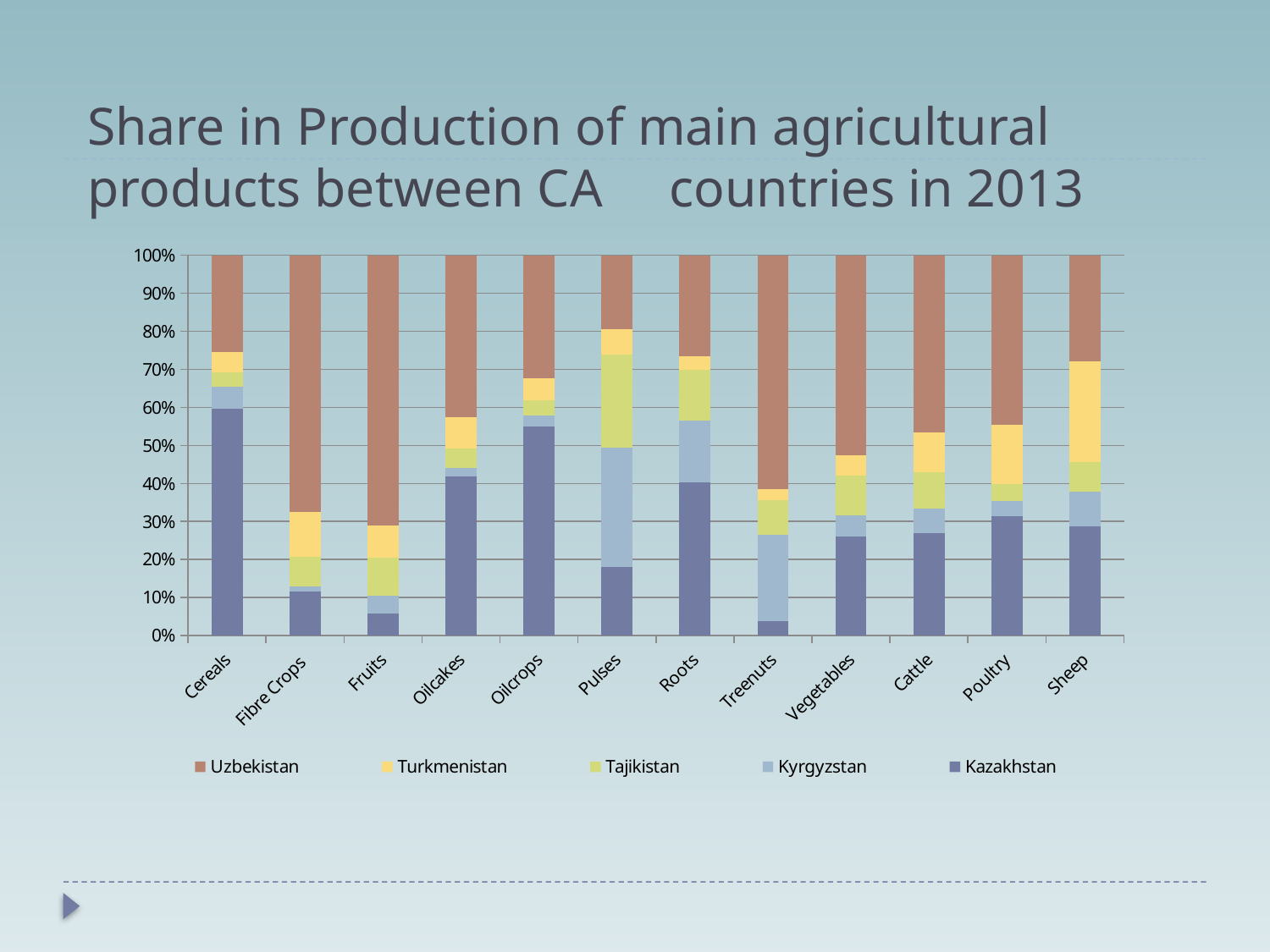
Is Kazakhstan's share of Fruits production greater or less than 10%? less How many product categories are shown on the x axis? 12 Is Kazakhstan's share of Roots production greater or less than 30%? greater What does each stacked bar total? 100% Is Kazakhstan's share of Oilcrops production greater or less than 50%? greater Which country is listed first in the legend? Uzbekistan Which is larger: Uzbekistan's share of Fibre Crops or Uzbekistan's share of Cereals? Fibre Crops What kind of chart is shown on the slide? Stacked bar chart Which is larger: Kazakhstan's share of Cereals or Kazakhstan's share of Fruits? Cereals How many countries does the legend list? 5